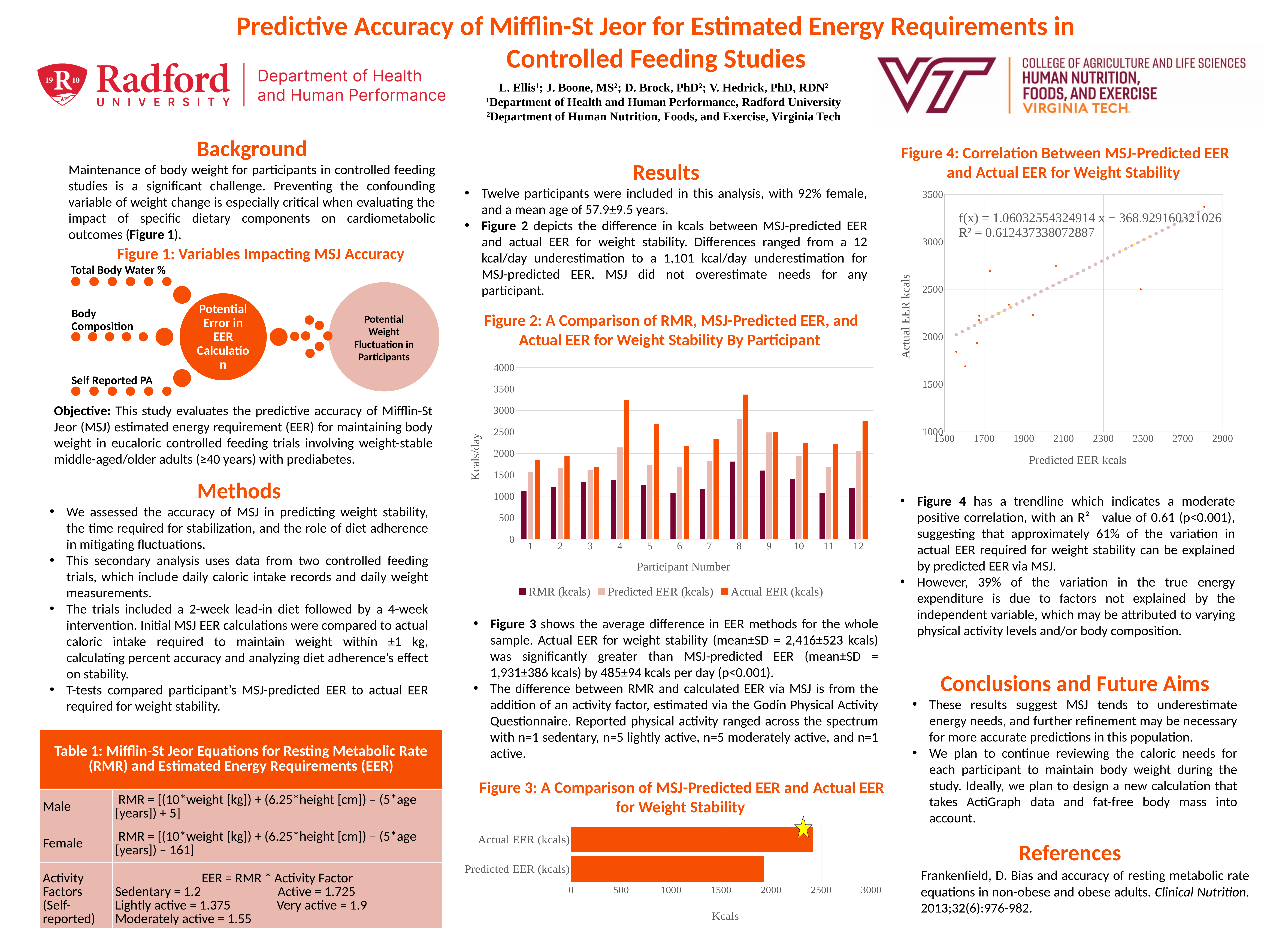
In Figure 2, is the Actual EER (kcals) value for participant 8 greater or less than 3000? greater In Figure 3, is the value for Predicted EER (kcals) greater or less than 2000? less In Figure 2, which participant has the lowest Actual EER (kcals)? 3 In Figure 2, for participant 4, which is larger: Predicted EER (kcals) or Actual EER (kcals)? Actual EER (kcals) In Figure 2, how many series does the legend list? 3 What kind of chart is Figure 3: A Comparison of MSJ-Predicted EER and Actual EER for Weight Stability? Bar chart What kind of chart is Figure 2: A Comparison of RMR, MSJ-Predicted EER, and Actual EER for Weight Stability By Participant? Bar chart In Figure 2, is the Actual EER (kcals) value for participant 1 greater or less than 2000? less In Figure 2, how many participants are shown on the x axis? 12 In Figure 3, which bar is larger: Actual EER (kcals) or Predicted EER (kcals)? Actual EER (kcals) In Figure 4, does Actual EER rise or fall as Predicted EER increases along the x axis? Rise In Figure 4: Correlation Between MSJ-Predicted EER and Actual EER for Weight Stability, what R² value is printed on the chart? 0.612437338072887